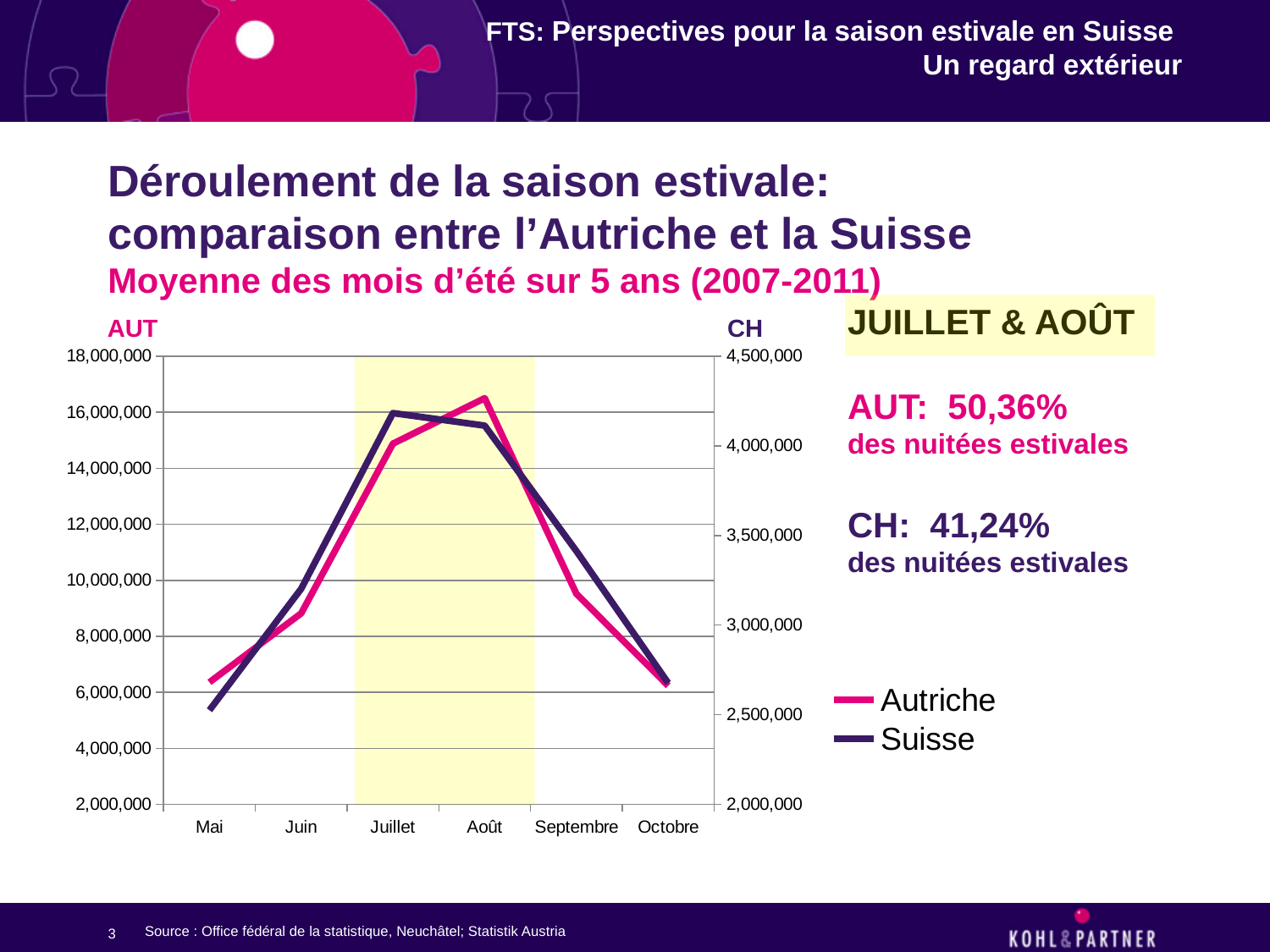
Is the Autriche value for Août greater or less than 16,000,000? greater Does the Suisse series rise or fall from Mai to Juillet? rise In which month does the Suisse series reach its highest value? Juillet How many months are plotted along the x axis of the chart? 6 How many series does the chart legend list? 2 Is the Suisse value for Mai greater or less than 3,000,000? less In which month does the Autriche series reach its highest value? Août Which is larger for the Autriche series: the value in Juillet or the value in Août? Août What kind of chart is shown on the slide? line chart In which month is the Suisse series at its lowest value? Mai Which two series are listed in the chart legend? Autriche and Suisse Is the Autriche value for Septembre greater or less than 12,000,000? less